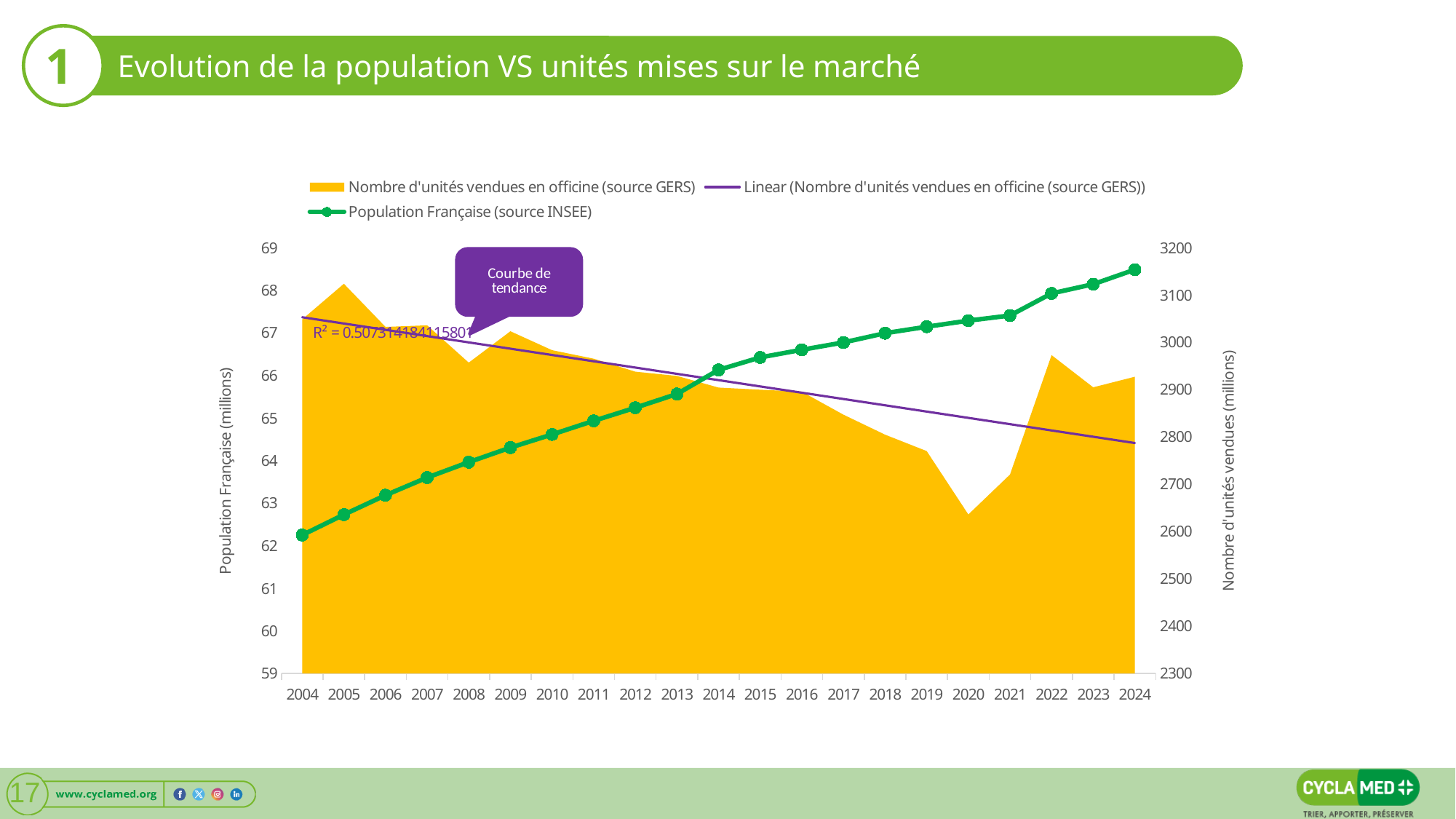
Does the linear trendline for units sold rise or fall from 2004 to 2024? Falls Is the Nombre d'unités vendues en officine value for 2020 greater or less than 2700? less Which year has the larger Nombre d'unités vendues en officine value, 2019 or 2022? 2022 Is the Population Française value for 2004 greater or less than 63? less In which year is the Population Française value highest? 2024 In which year is the Population Française value lowest? 2004 What kind of chart is shown on the slide? A combined area and line chart How many series does the legend list? 3 How many years are shown along the x axis? 21 In which year is the Nombre d'unités vendues en officine value lowest? 2020 What R² value is printed on the chart for the trendline? R² = 0.507314184115801 Does the Population Française series rise or fall from 2004 to 2024? Rises